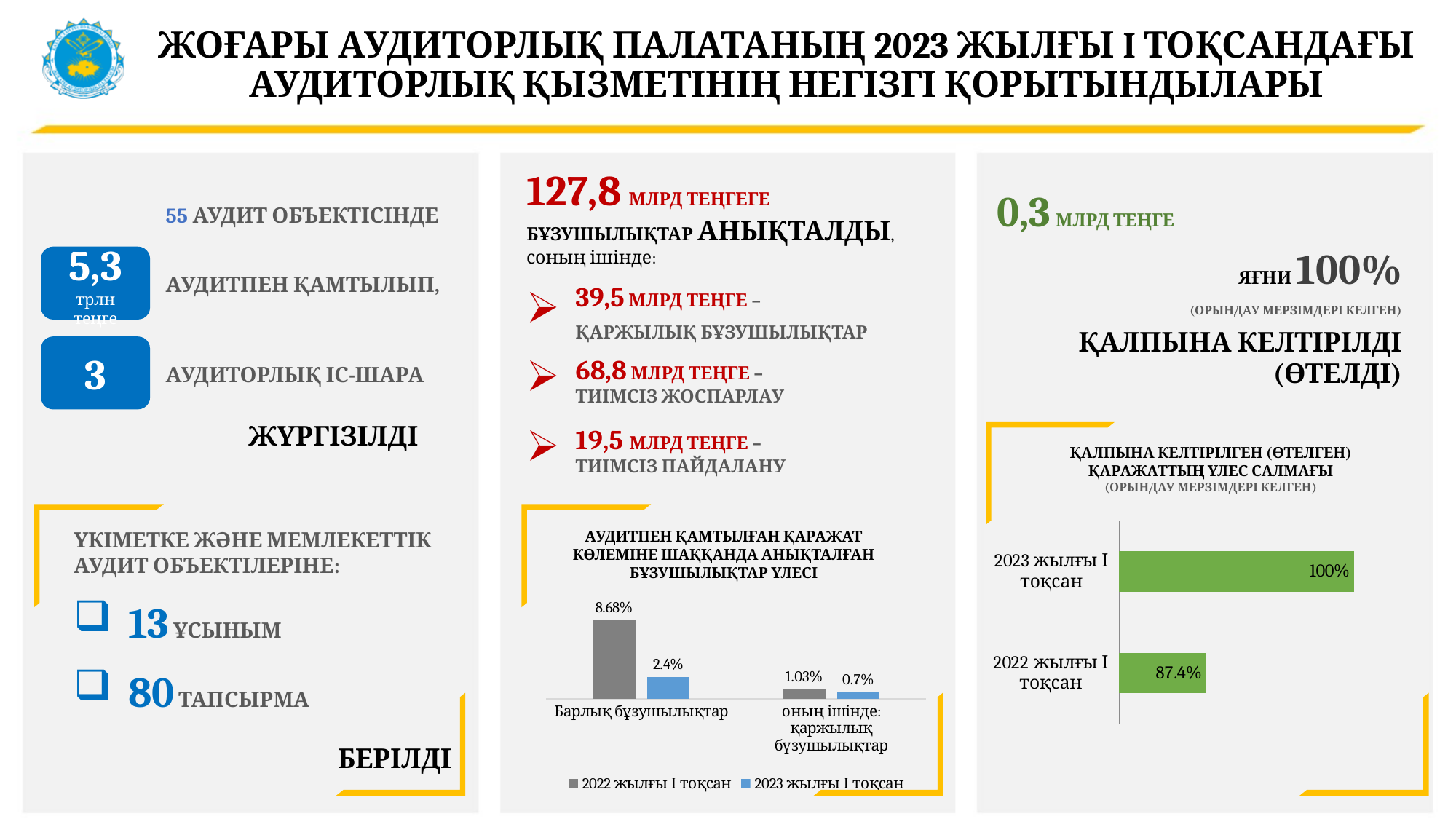
In the middle chart (АУДИТПЕН ҚАМТЫЛҒАН ҚАРАЖАТ КӨЛЕМІНЕ ШАҚҚАНДА АНЫҚТАЛҒАН БҰЗУШЫЛЫҚТАР ҮЛЕСІ), what is the value for Барлық бұзушылықтар in the 2022 жылғы I тоқсан series? 8.68% In the right chart (ҚАЛПЫНА КЕЛТІРІЛГЕН (ӨТЕЛГЕН) ҚАРАЖАТТЫҢ ҮЛЕС САЛМАҒЫ), what is the value for 2022 жылғы I тоқсан? 87.4% What kind of chart is the right chart (ҚАЛПЫНА КЕЛТІРІЛГЕН (ӨТЕЛГЕН) ҚАРАЖАТТЫҢ ҮЛЕС САЛМАҒЫ)? bar chart In the middle chart, what is the value for оның ішінде: қаржылық бұзушылықтар in the 2022 жылғы I тоқсан series? 1.03% In the middle chart, what is the value for оның ішінде: қаржылық бұзушылықтар in the 2023 жылғы I тоқсан series? 0.7% In the middle chart, which bar has the highest value? Барлық бұзушылықтар, 2022 жылғы I тоқсан In the middle chart, what is the value for Барлық бұзушылықтар in the 2023 жылғы I тоқсан series? 2.4% In the right chart, what is the difference between the 2023 жылғы I тоқсан and 2022 жылғы I тоқсан values? 12.6% In the middle chart, what is the difference between the 2022 жылғы I тоқсан and 2023 жылғы I тоқсан values for Барлық бұзушылықтар? 6.28% In the middle chart, how many series does the legend list? 2 In the right chart, what is the value for 2023 жылғы I тоқсан? 100% In the middle chart, which series is shown in blue? 2023 жылғы I тоқсан